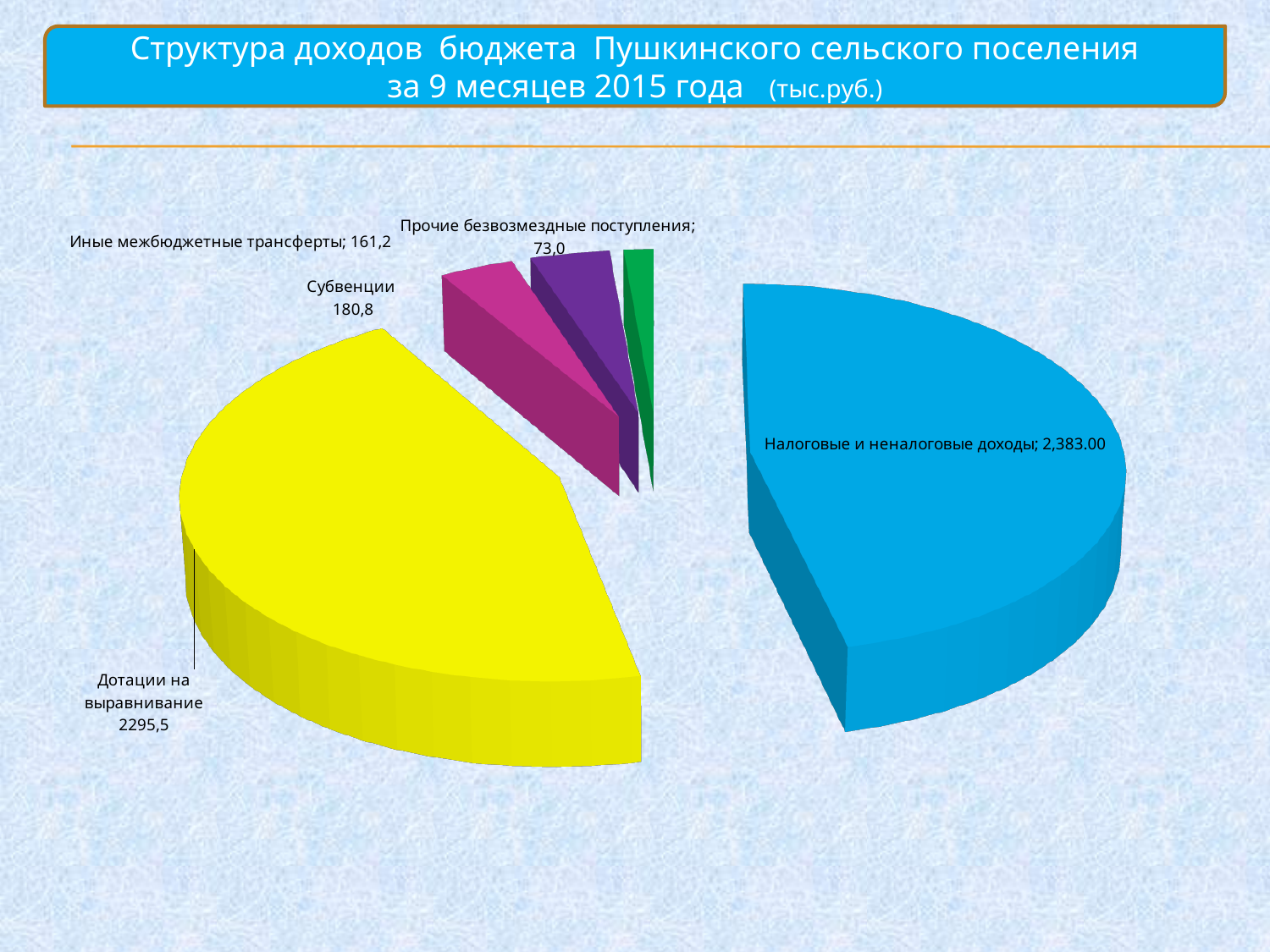
What kind of chart is shown on the slide? Pie chart What is the difference between Субвенции and Иные межбюджетные трансферты? 19,6 Which is larger, Субвенции or Прочие безвозмездные поступления? Субвенции What is the value for Дотации на выравнивание? 2295,5 What is the value for Иные межбюджетные трансферты? 161,2 Which category has the largest value? Налоговые и неналоговые доходы Which category has the smallest value? Прочие безвозмездные поступления How many categories are shown in the chart? 5 What is the value for Субвенции? 180,8 What is the value for Прочие безвозмездные поступления? 73,0 Which category is shown in yellow? Дотации на выравнивание What is the value for Налоговые и неналоговые доходы? 2,383.00